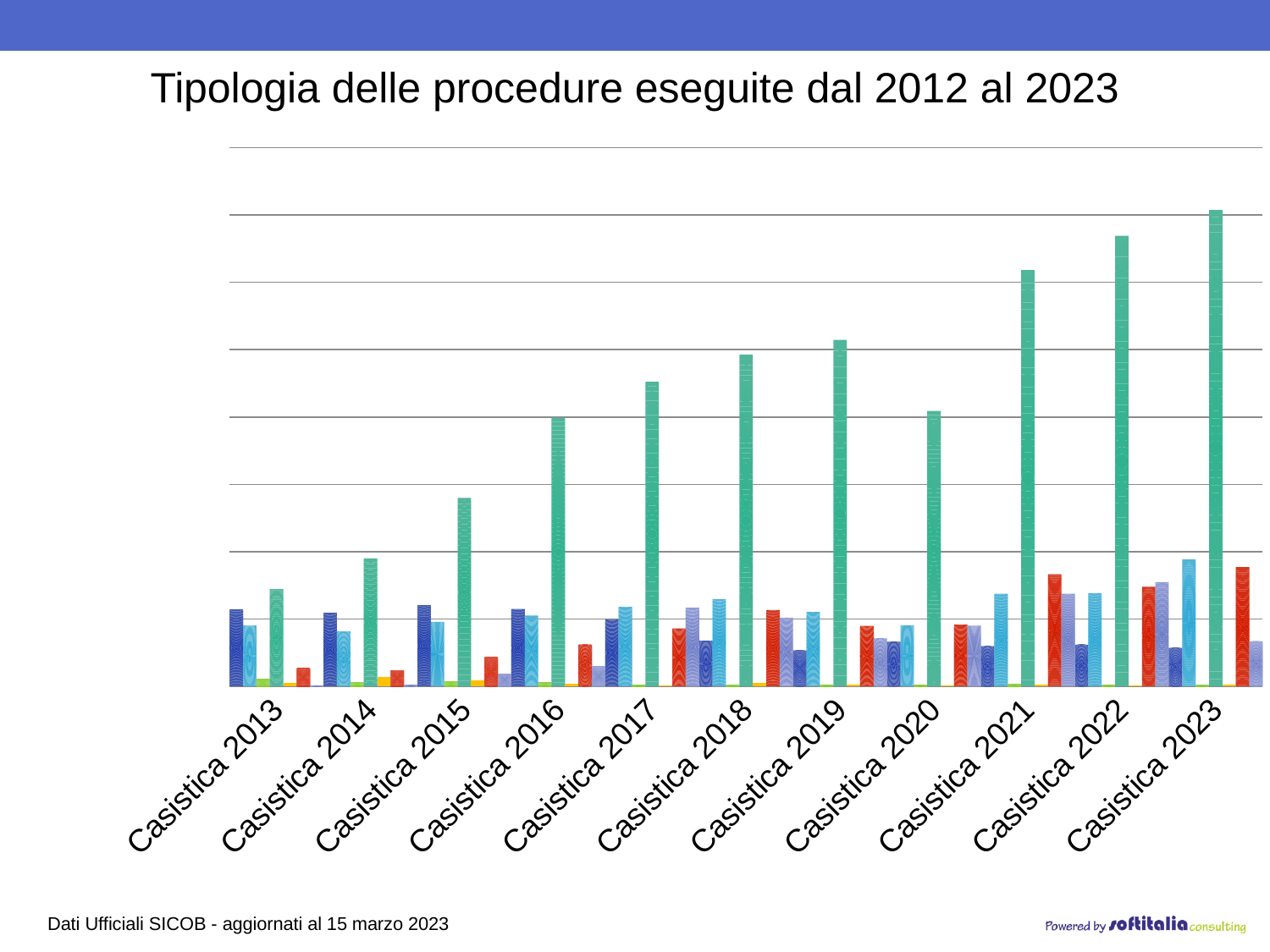
Which category contains the tallest bar in the whole chart? Casistica 2023 Which has the taller green bar, Casistica 2019 or Casistica 2020? Casistica 2019 What kind of chart is shown on the slide? bar chart Which category has the shortest green bar? Casistica 2013 Which has the taller green bar, Casistica 2015 or Casistica 2016? Casistica 2016 What is the title of the chart? Tipologia delle procedure eseguite dal 2012 al 2023 Do the green bars rise or fall from Casistica 2020 to Casistica 2023? rise Do the green bars rise or fall from Casistica 2013 to Casistica 2019? rise Which has the taller red bar, Casistica 2013 or Casistica 2023? Casistica 2023 How many categories are shown along the x axis of the chart? 11 What is the label of the first category on the x axis? Casistica 2013